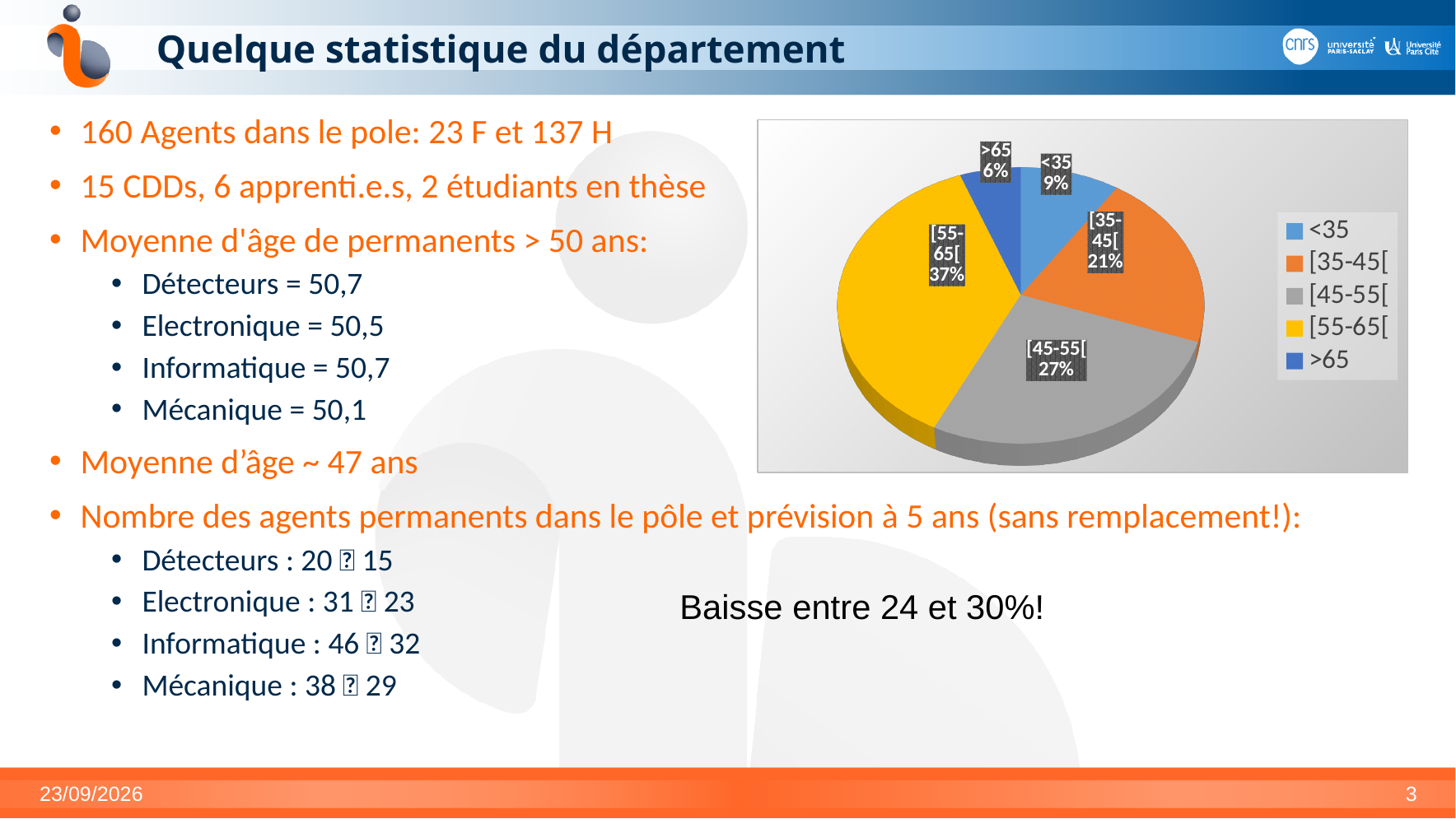
Which age group has the smallest slice of the pie? >65 What share of the pie does the [35-45[ age group represent? 21% What kind of chart is shown on the slide? pie chart What share of the pie does the <35 age group represent? 9% What is the difference in percentage points between the [55-65[ slice and the [45-55[ slice? 10 What share of the pie does the [55-65[ age group represent? 37% How many age groups are shown in the pie chart? 5 What colour is the [55-65[ slice in the pie chart? yellow Which age group has the largest slice of the pie? [55-65[ Which slice is larger, [35-45[ or [45-55[? [45-55[